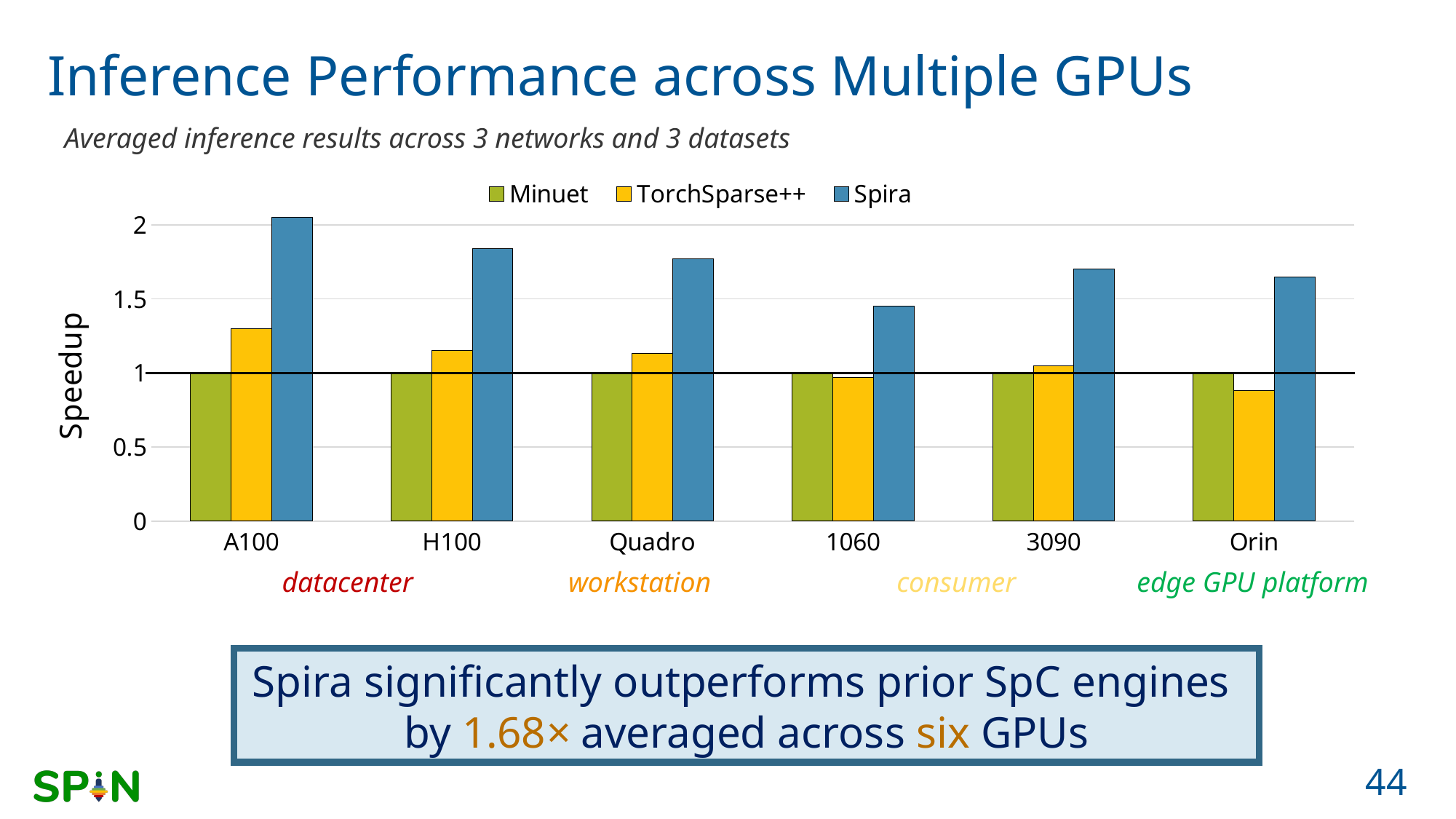
What is the Minuet speedup for H100? 1 What is the label on the y axis? Speedup Is the Spira speedup for A100 greater or less than 2? greater How many GPU categories are shown on the x axis? 6 Which is larger for Quadro: the TorchSparse++ speedup or the Spira speedup? Spira How many series does the legend list? 3 Which GPU has the highest Spira speedup? A100 What kind of chart is shown on the slide? bar chart Is the Spira speedup for 1060 greater or less than 1.5? less Which GPU has the lowest Spira speedup? 1060 Which GPU has the highest TorchSparse++ speedup? A100 Is the TorchSparse++ speedup for Orin greater or less than 1? less